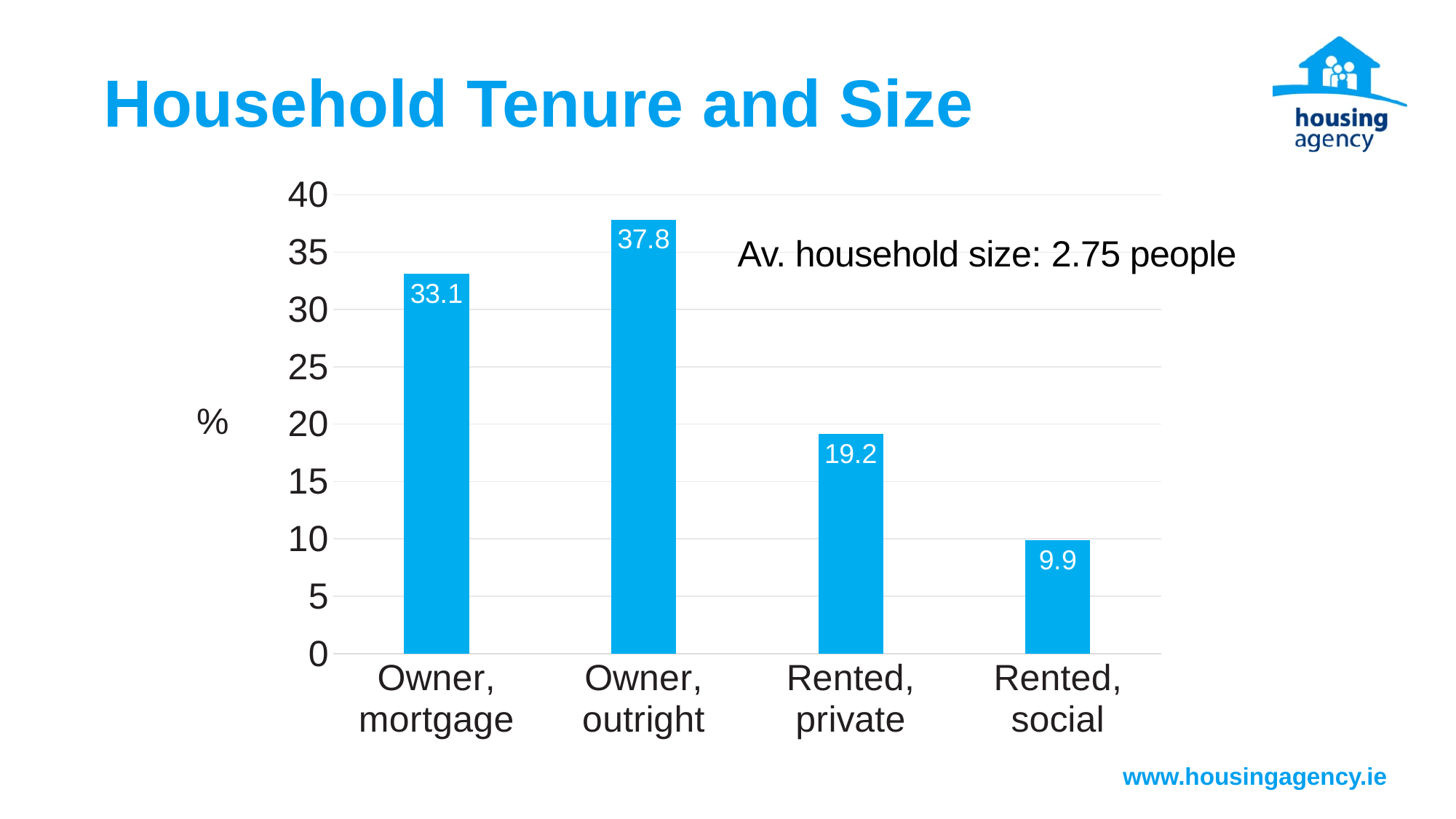
What is the difference between the values for Rented, private and Rented, social? 9.3 What kind of chart is shown on the slide? Bar chart What is the value for Rented, social? 9.9 How many categories are shown on the x axis? 4 What is the difference between the values for Owner, outright and Owner, mortgage? 4.7 What is the value for Owner, mortgage? 33.1 Which category has the lowest value? Rented, social What is the label on the vertical axis? % What is the value for Rented, private? 19.2 Which is larger, the value for Rented, private or the value for Rented, social? Rented, private Which category has the highest value? Owner, outright What is the value for Owner, outright? 37.8